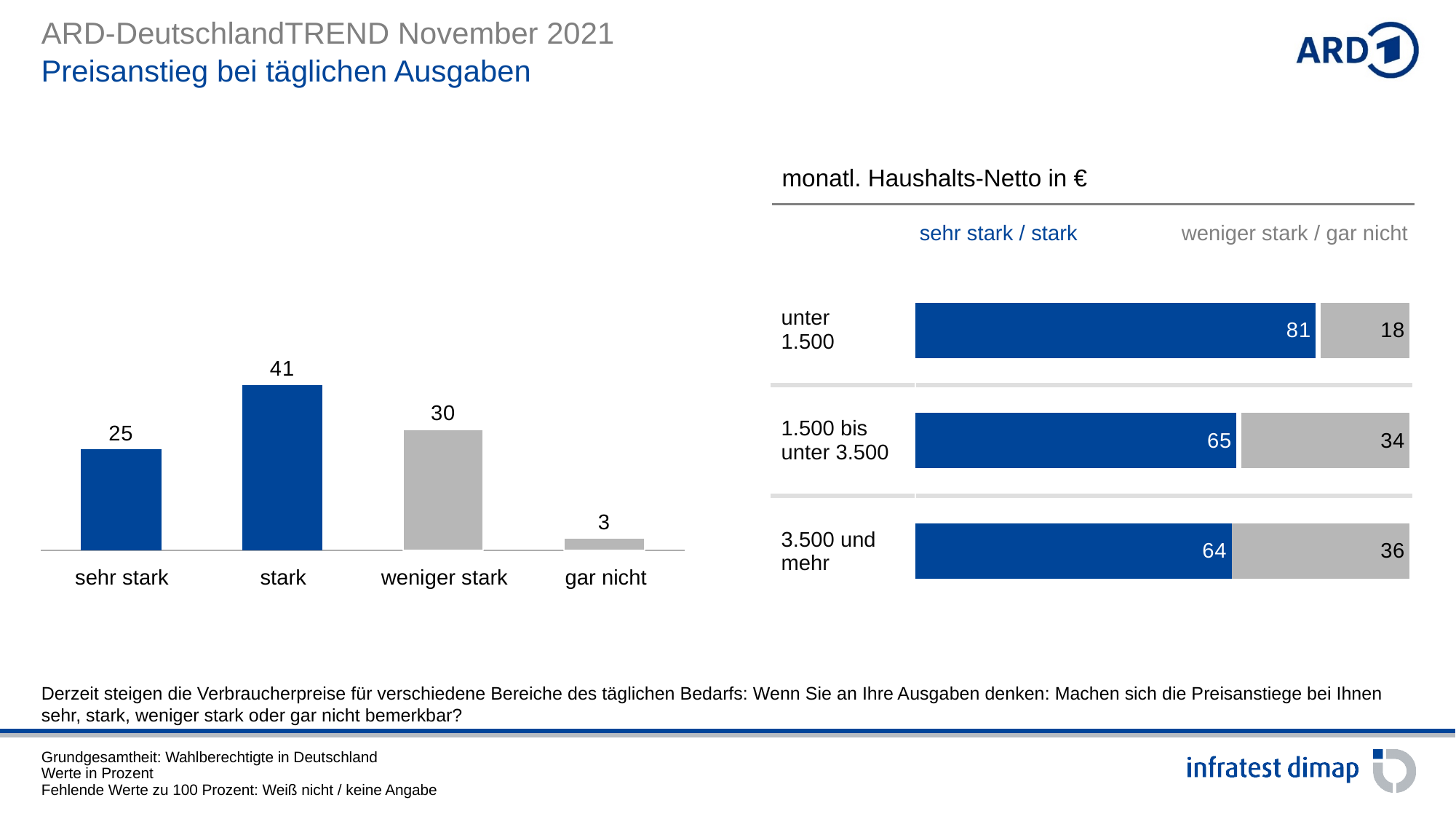
In the right chart "monatl. Haushalts-Netto in €", what is the total of the two values for "1.500 bis unter 3.500"? 99 In the left bar chart, which category has the lowest value? gar nicht In the left bar chart, how many categories are shown? 4 What kind of chart is the chart on the left? bar chart In the left bar chart, which category has the highest value? stark In the right chart "monatl. Haushalts-Netto in €", what is the "sehr stark / stark" value for "unter 1.500"? 81 In the right chart "monatl. Haushalts-Netto in €", how many series are shown in the legend? 2 In the right chart "monatl. Haushalts-Netto in €", what is the "weniger stark / gar nicht" value for "3.500 und mehr"? 36 In the left bar chart, what is the value for "gar nicht"? 3 In the left bar chart, what is the value for "stark"? 41 In the left bar chart, what is the difference between the values for "stark" and "sehr stark"? 16 In the right chart "monatl. Haushalts-Netto in €", which income group has the highest "sehr stark / stark" value? unter 1.500